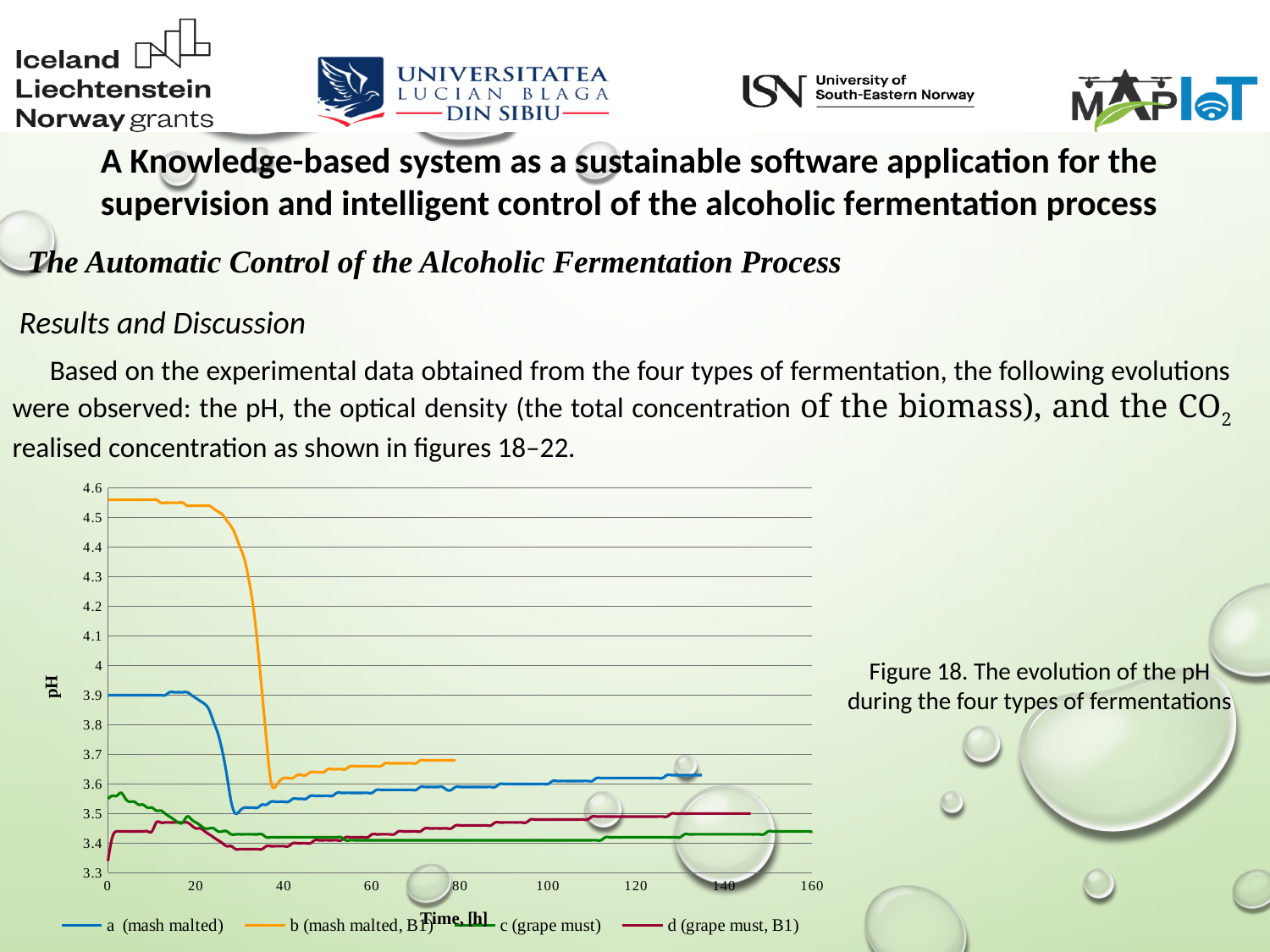
Is the pH of series d (grape must, B1) at time 0 greater or less than 3.4? less What type of chart is shown on the slide? line chart Does the pH of series b (mash malted, B1) rise or fall between 20 h and 40 h? fall Is the pH of series b (mash malted, B1) at time 0 greater or less than 4.5? greater Which series has the lowest pH at time 0? d (grape must, B1) Is the pH of series a (mash malted) at time 0 greater or less than 4? less How many series does the legend of the pH chart list? 4 What is the label of the vertical axis of the chart? pH Which series in the chart extends furthest along the time axis, reaching 160 h? c (grape must) Which series has the highest pH at time 0? b (mash malted, B1) At time 0, which series has the higher pH, a (mash malted) or c (grape must)? a (mash malted)